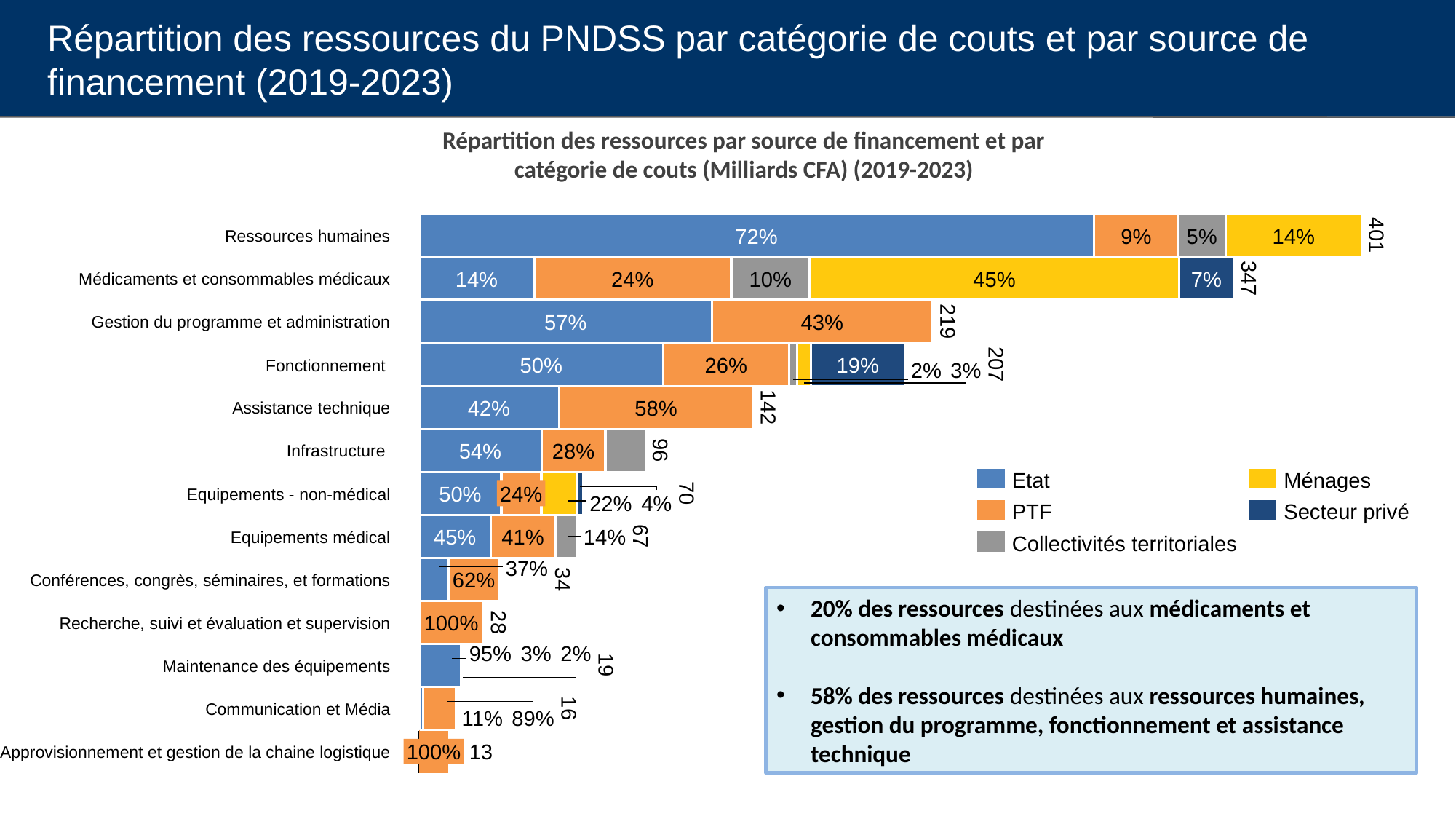
How many cost categories are plotted on the chart? 13 How many funding sources does the legend list? 5 What is the difference between the totals for Ressources humaines and Médicaments et consommables médicaux? 54 Which cost category has the largest total amount? Ressources humaines What share of the Médicaments et consommables médicaux resources comes from Ménages? 45% Which has a larger total, Infrastructure or Equipements médical? Infrastructure What share of the Gestion du programme et administration resources comes from PTF? 43% Which cost category has the smallest total amount? Approvisionnement et gestion de la chaine logistique What share of the Fonctionnement resources comes from Secteur privé? 19% What is the total amount (Milliards CFA) shown for Assistance technique? 142 What kind of chart is shown on the slide? Stacked bar chart What share of the Ressources humaines resources comes from Etat? 72%